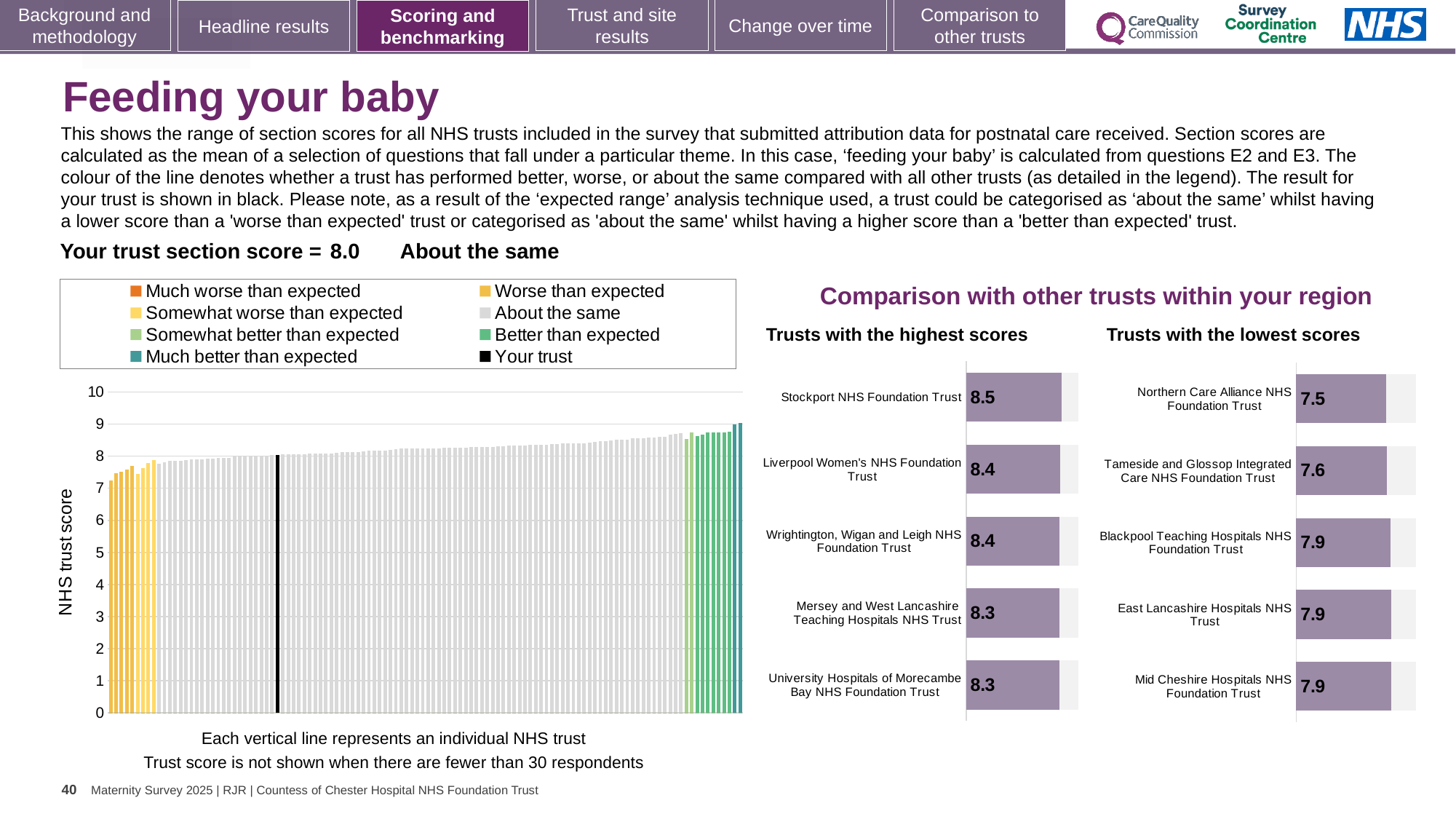
How many trusts are shown in the 'Trusts with the highest scores' chart? 5 In the 'Trusts with the lowest scores' chart, what is the score for Tameside and Glossop Integrated Care NHS Foundation Trust? 7.6 In the 'Trusts with the highest scores' chart, which has the larger score: Liverpool Women's NHS Foundation Trust or Mersey and West Lancashire Teaching Hospitals NHS Trust? Liverpool Women's NHS Foundation Trust In the 'Trusts with the lowest scores' chart, what is the difference between the scores of Mid Cheshire Hospitals NHS Foundation Trust and Northern Care Alliance NHS Foundation Trust? 0.4 In the 'Trusts with the highest scores' chart, what is the difference between the scores of Stockport NHS Foundation Trust and University Hospitals of Morecambe Bay NHS Foundation Trust? 0.2 How many entries does the legend of the main 'NHS trust score' chart list? 8 In the 'Trusts with the lowest scores' chart, what is the score for Northern Care Alliance NHS Foundation Trust? 7.5 In the main 'NHS trust score' chart, is the value for the black bar (your trust) greater or less than 7? greater In the main 'NHS trust score' chart, do the values rise or fall from left to right? rise In the 'Trusts with the highest scores' chart, what is the score for Stockport NHS Foundation Trust? 8.5 In the 'Trusts with the highest scores' chart, which trust has the highest score? Stockport NHS Foundation Trust In the 'Trusts with the lowest scores' chart, which trust has the lowest score? Northern Care Alliance NHS Foundation Trust